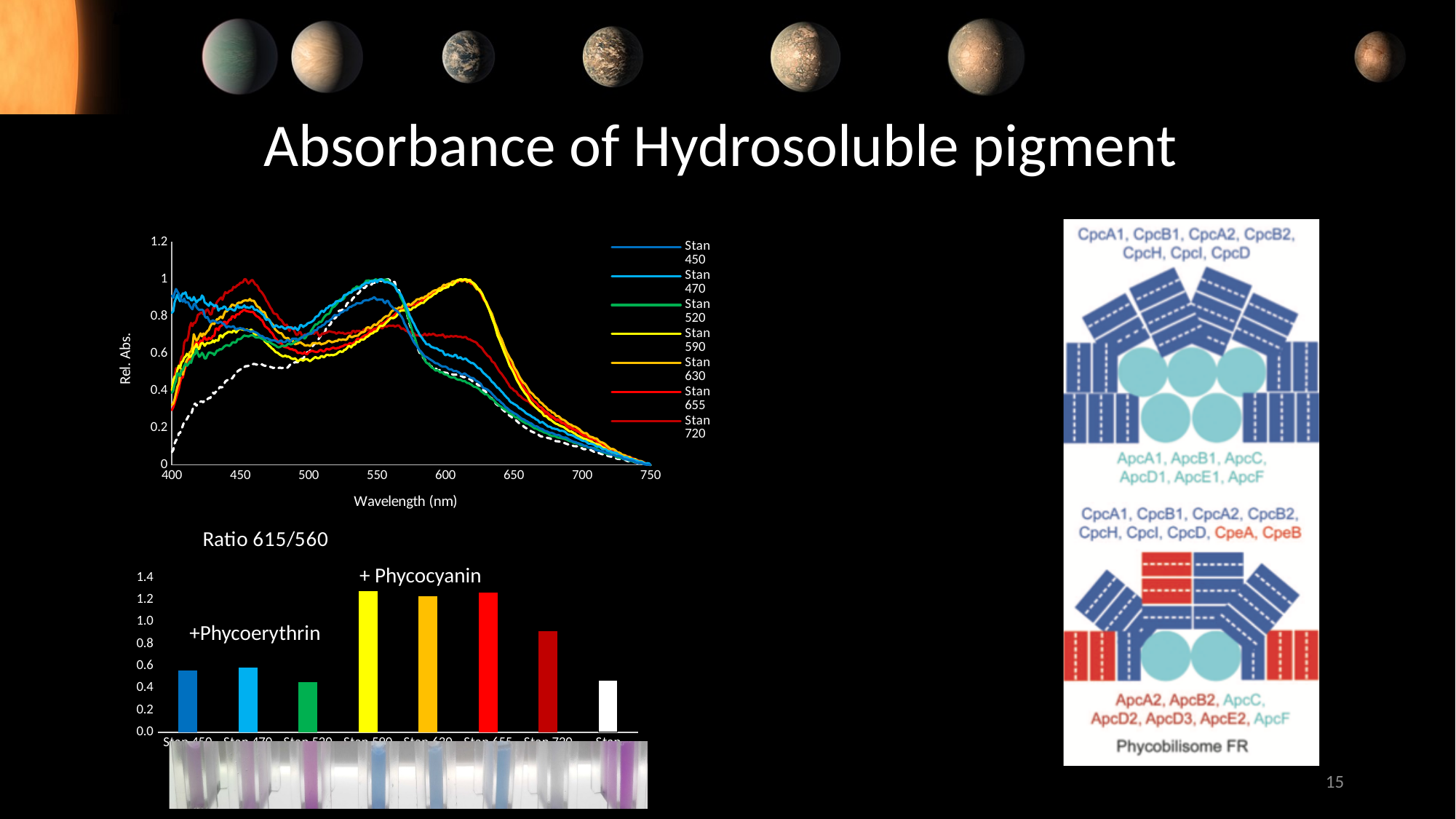
In the bottom-left Ratio 615/560 chart, is the value for Stan 590 greater or less than 1.0? greater What kind of chart is the bottom-left chart titled Ratio 615/560? bar chart In the bottom-left Ratio 615/560 chart, is the value for Stan 630 greater or less than 1.0? greater In the bottom-left Ratio 615/560 chart, is the value for Stan 450 greater or less than 0.8? less In the bottom-left Ratio 615/560 chart, which is larger, the value for Stan 470 or the value for Stan 520? Stan 470 What is the x-axis title of the top-left absorbance chart? Wavelength (nm) What kind of chart is the top-left chart showing absorbance versus wavelength? line chart In the top-left absorbance chart, how many series does the legend list? 7 In the bottom-left Ratio 615/560 chart, how many bars are plotted? 8 In the bottom-left Ratio 615/560 chart, which is larger, the value for Stan 630 or the value for Stan 720? Stan 630 What is the title of the bottom-left bar chart? Ratio 615/560